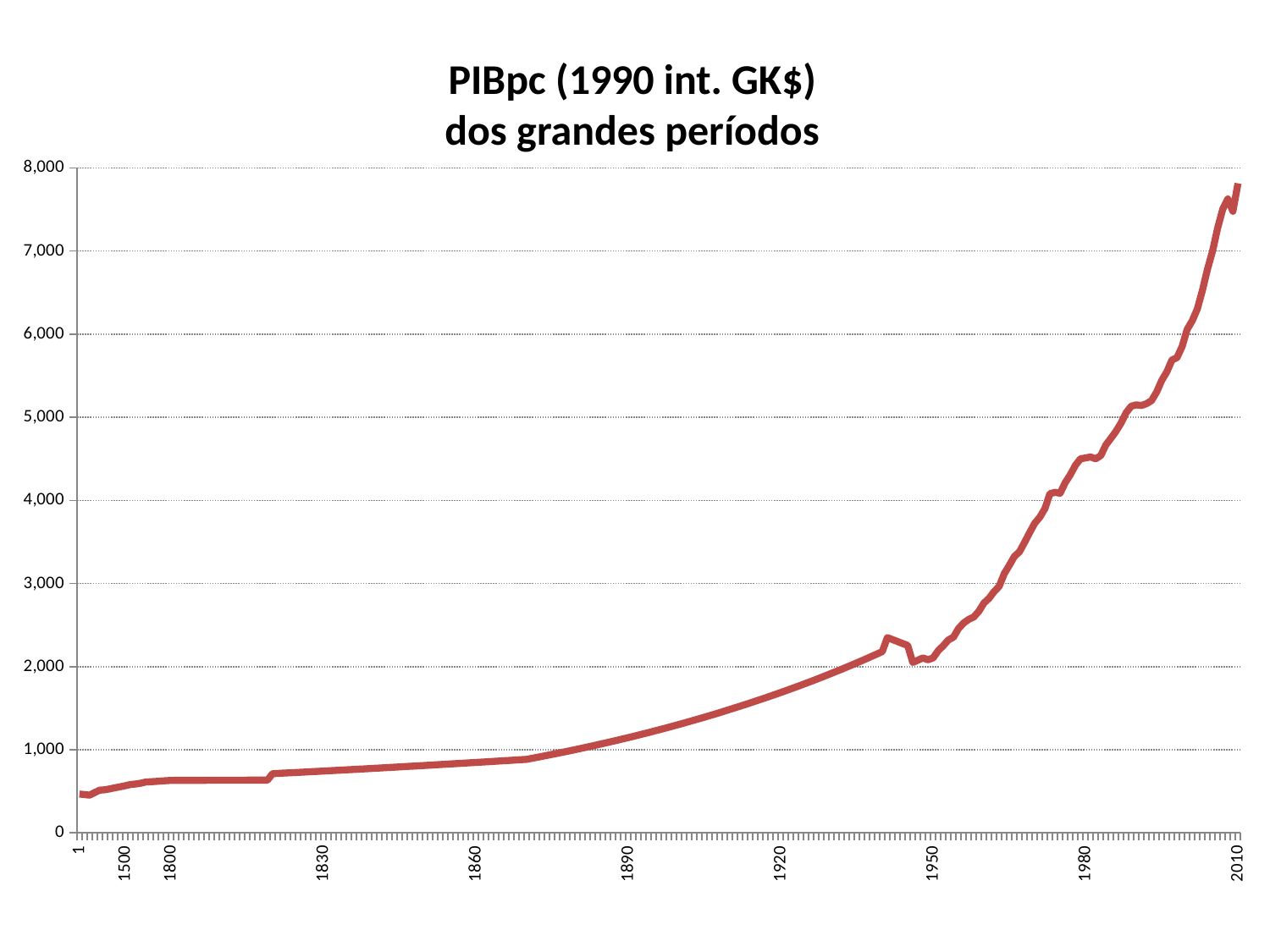
What is the title of the chart? PIBpc (1990 int. GK$) dos grandes períodos Is the value for 2010 greater or less than 7,000? greater Is the value for 1980 greater or less than 4,000? greater What kind of chart is shown on the slide? line chart Is the value for 1920 greater or less than 2,000? less Which labelled year on the x axis has the highest value? 2010 What is the highest value shown on the y axis? 8,000 Which is larger, the value for 1980 or the value for 1920? 1980 Do the values generally rise or fall along the x axis from 1 to 2010? rise